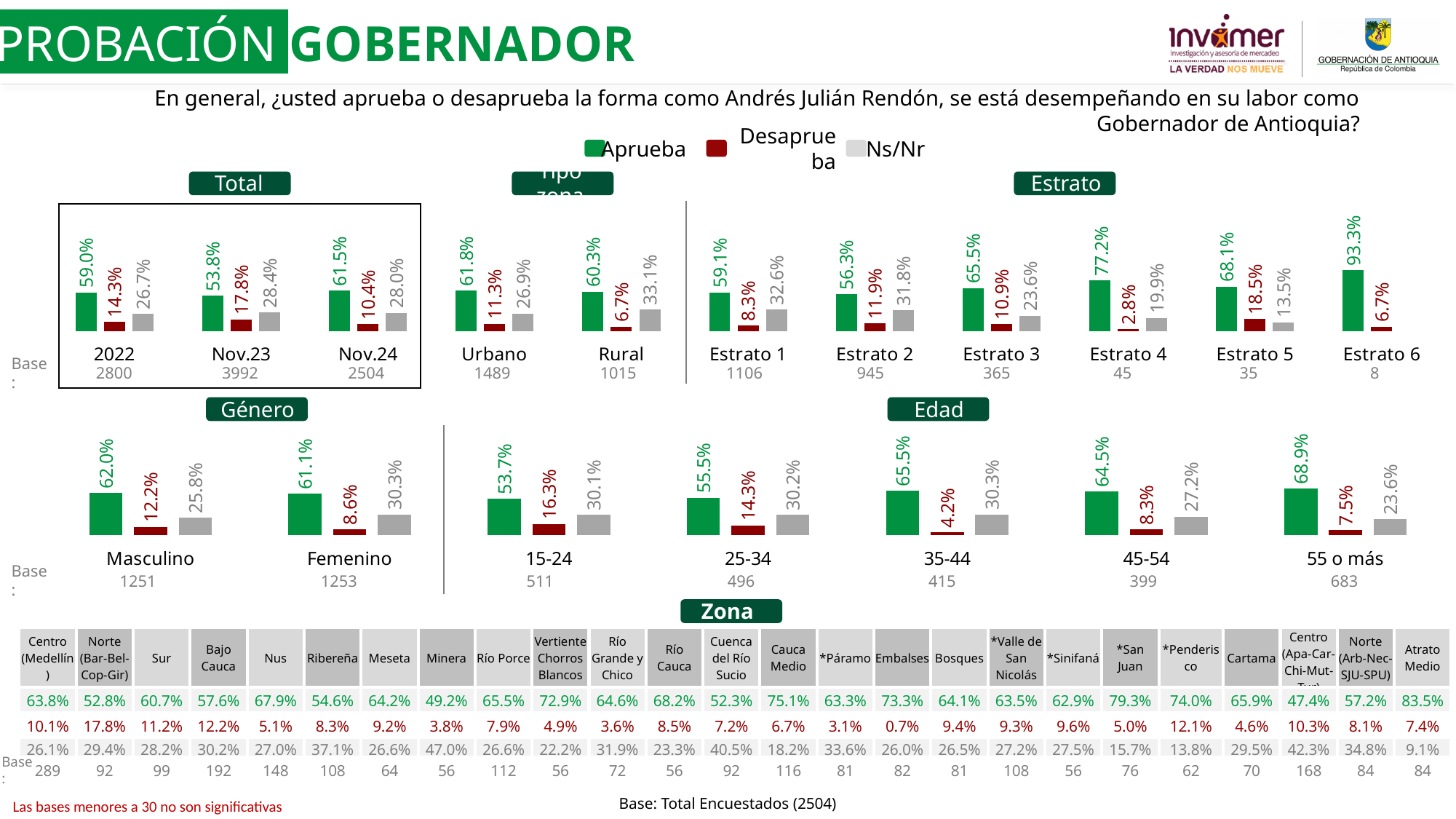
How many age groups are shown in the Edad chart? 5 How many series does the legend list? 3 What kind of chart is used in the Estrato section? Bar chart In the Tipo zona chart, what is the difference between the Ns/Nr values for Rural and Urbano? 6.2 percentage points In the Género chart, which group has the larger Aprueba value, Masculino or Femenino? Masculino In the Edad chart, what is the difference between the Aprueba values for 55 o más and 15-24? 15.2 percentage points In the Estrato chart, which estrato has the lowest Desaprueba value? Estrato 4 What colour represents Desaprueba in the legend? Dark red In the Total chart, what is the Desaprueba value for Nov.23? 17.8% In the Total chart, what is the Aprueba value for Nov.24? 61.5% In the Edad chart, what is the Ns/Nr value for 55 o más? 23.6% In the Estrato chart, which estrato has the highest Aprueba value? Estrato 6